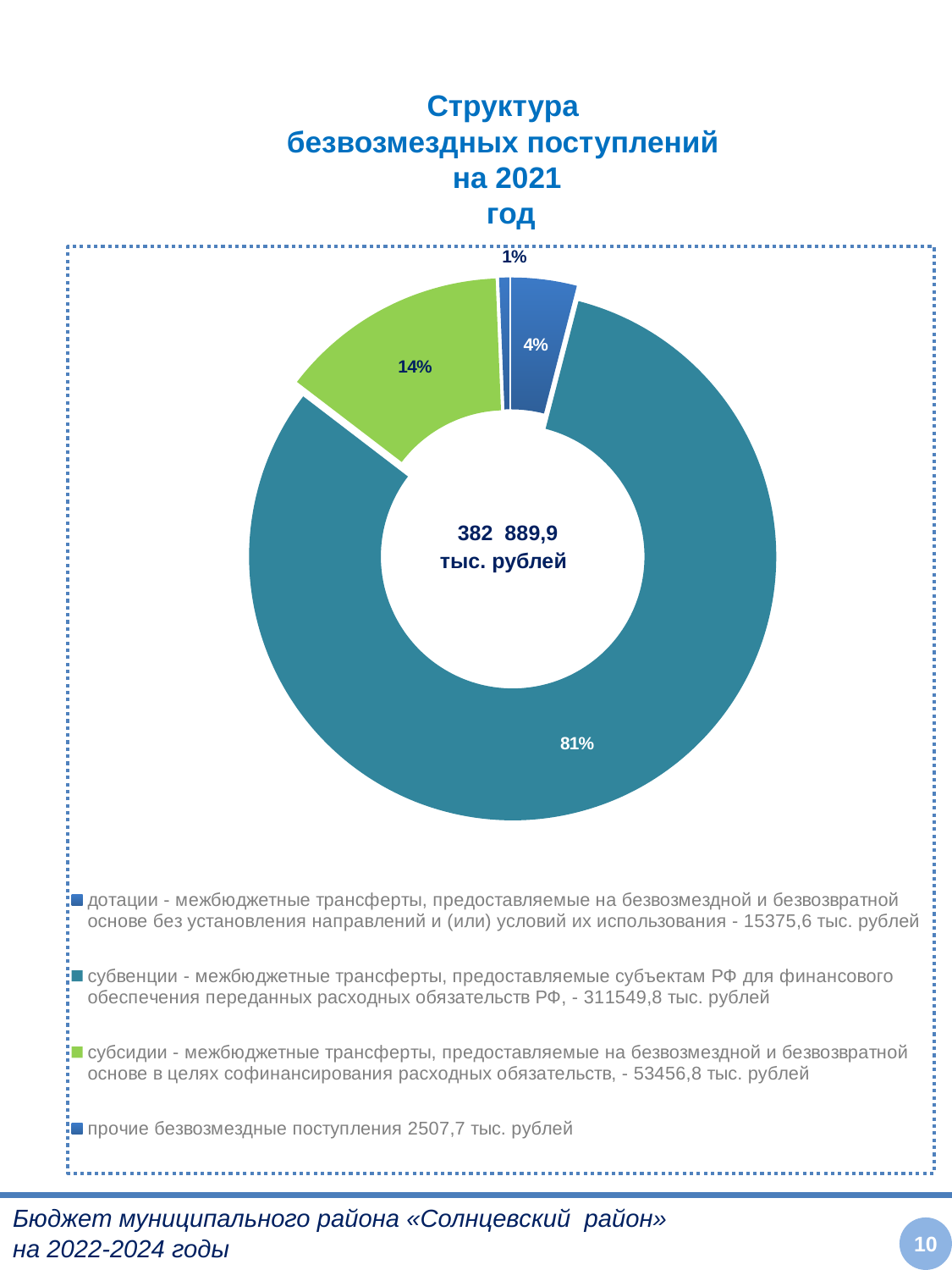
What share of the pie does субвенции (teal slice) represent? 81% What share of the pie does дотации represent? 4% According to the legend, what is the amount for субвенции? 311549,8 тыс. рублей What kind of chart is shown on the slide? pie chart (donut) Which slice is larger, дотации or субсидии? субсидии According to the legend, what is the amount for субсидии? 53456,8 тыс. рублей What share of the pie does субсидии (green slice) represent? 14% What total value is shown in the centre of the donut chart? 382 889,9 тыс. рублей Which category has the smallest slice of the pie? прочие безвозмездные поступления Which category has the largest slice of the pie? субвенции How many slices does the pie chart have? 4